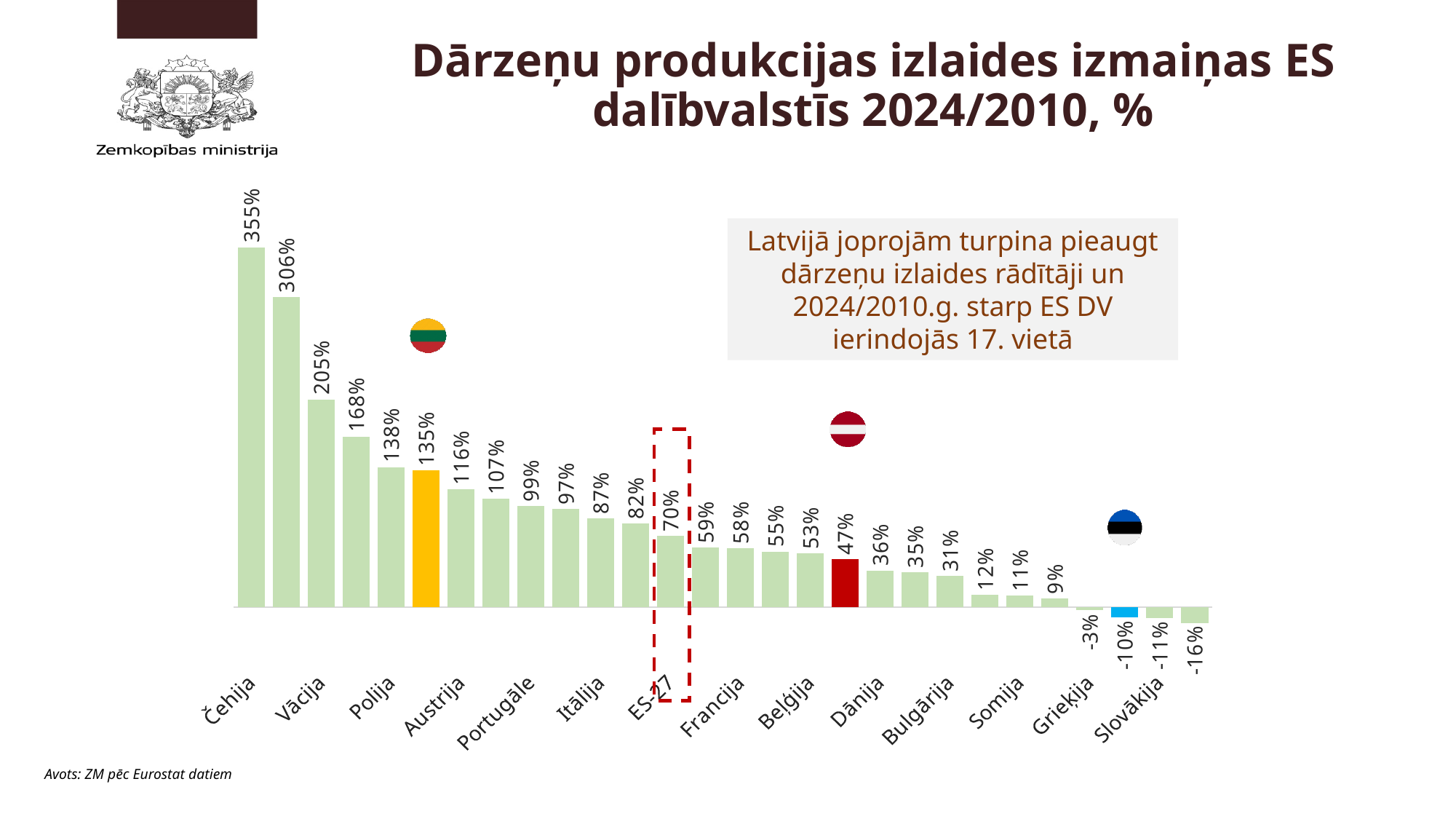
How many bars are plotted in the chart? 28 Which country has the highest value in the chart? Čehija What is the value shown for Polija? 138% What is the difference between the values for Vācija and Polija? 67 percentage points What is the value shown for Čehija? 355% Which has the larger value, Francija or Beļģija? Francija Do the values rise or fall from left to right along the x axis? Fall What is the lowest value shown in the chart? -16% What kind of chart is shown on the slide? Bar chart What value is labelled on the dark red bar? 47% What is the value shown for Slovākija? -11% What is the value shown for ES-27? 70%